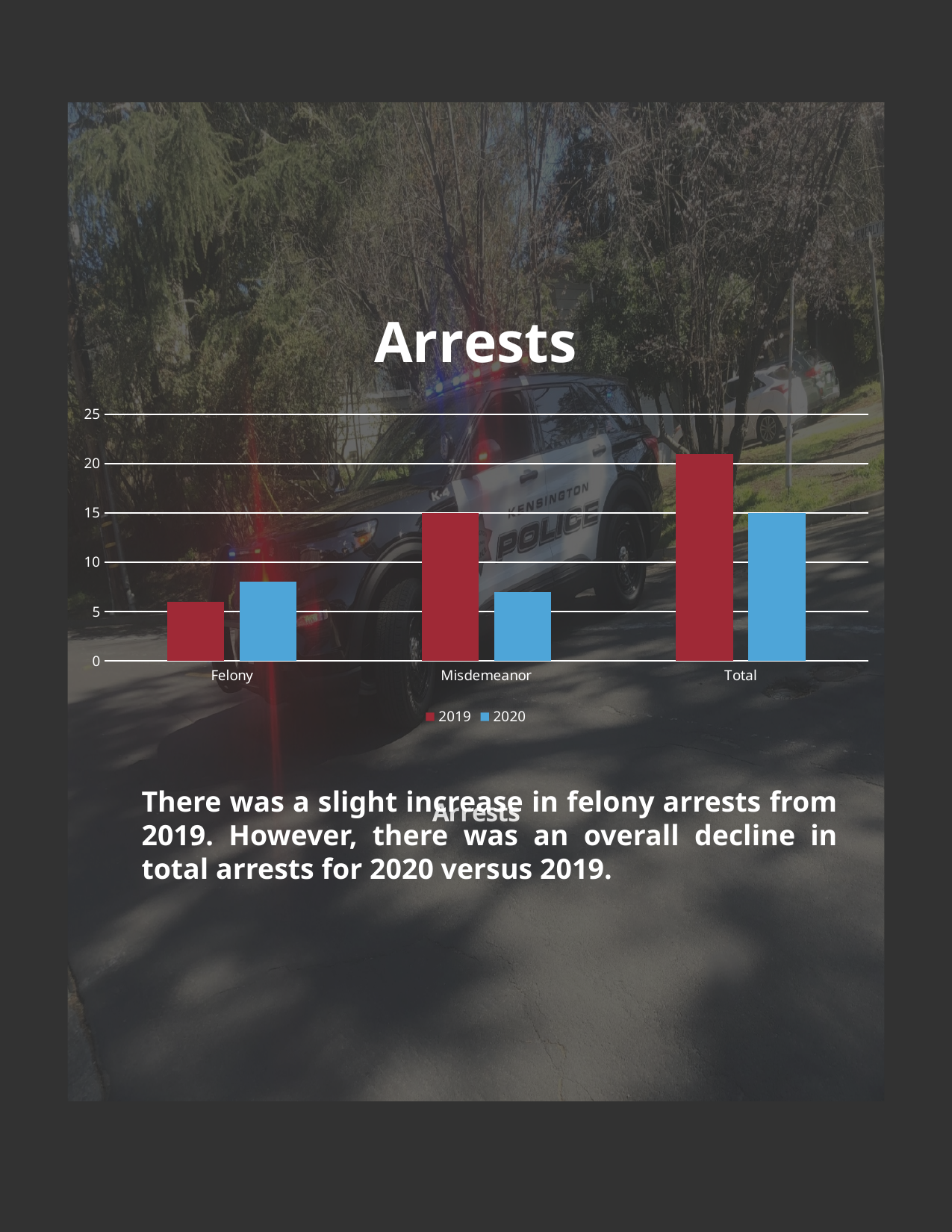
For Felony, which year has the larger value, 2019 or 2020? 2020 How many categories are shown on the x axis? 3 Is the value for Total in 2019 greater or less than 20? greater Which colour represents the 2020 series? blue How many series does the legend list? 2 What kind of chart is shown on the slide? bar chart What is the value for Total in 2020? 15 Which category has the highest 2019 value? Total Which category has the lowest 2019 value? Felony What is the title of the chart? Arrests What is the value for Misdemeanor in 2019? 15 Is the value for Misdemeanor in 2020 greater or less than 10? less